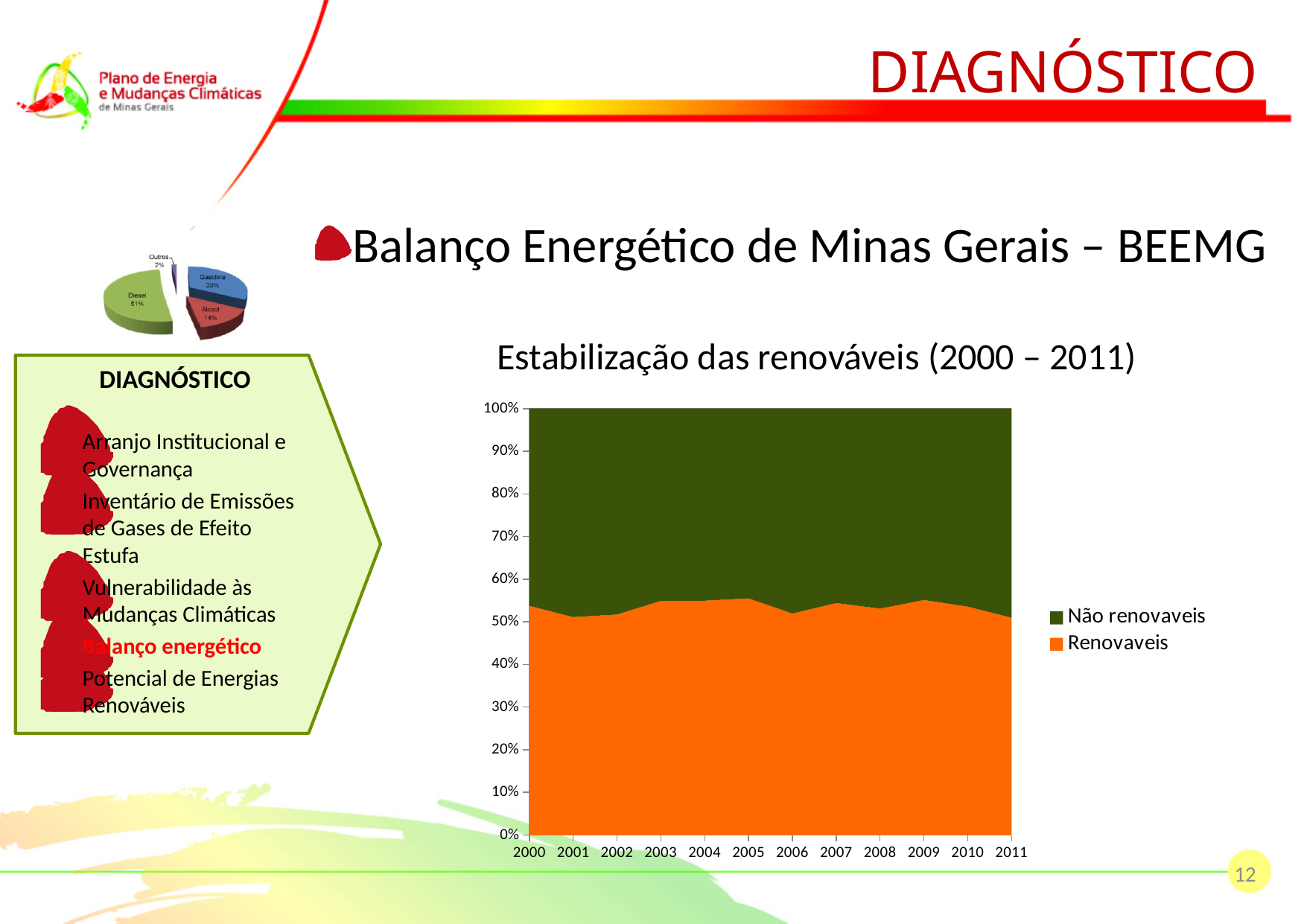
In the 'Estabilização das renováveis (2000 – 2011)' chart, is the share of Renovaveis in 2004 greater or less than 60%? less What kind of chart is the 'Estabilização das renováveis (2000 – 2011)' chart? Area chart In the 'Estabilização das renováveis (2000 – 2011)' chart, how many series does the legend list? 2 In the 'Estabilização das renováveis (2000 – 2011)' chart, is the share of Renovaveis in 2000 greater or less than 50%? greater In the 'Estabilização das renováveis (2000 – 2011)' chart, which colour represents Renovaveis? Orange In the 'Estabilização das renováveis (2000 – 2011)' chart, what is the first year shown on the x axis? 2000 In the small pie chart on the left of the slide, what share does Gasolina have? 33% In the 'Estabilização das renováveis (2000 – 2011)' chart, is the share of Não renovaveis in 2005 greater or less than 50%? less In the small pie chart on the left of the slide, which slice is the largest? Diesel In the 'Estabilização das renováveis (2000 – 2011)' chart, what are the two legend entries? Não renovaveis and Renovaveis In the 'Estabilização das renováveis (2000 – 2011)' chart, how many years are shown on the x axis? 12